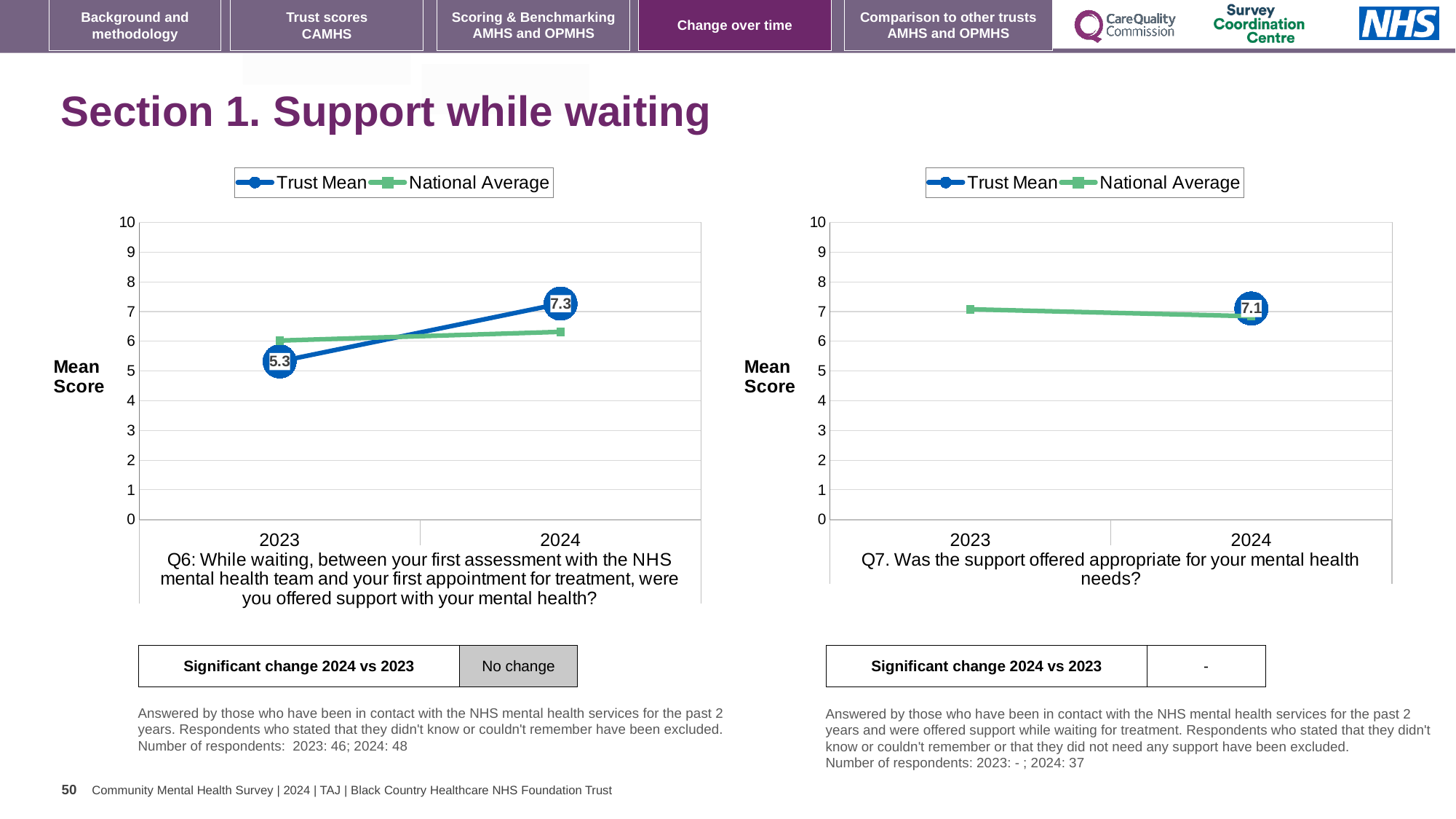
In the left chart (Q6), is the National Average value for 2023 greater or less than 5? greater How many years are shown on the x axis of the left chart (Q6)? 2 In the left chart (Q6), what is the Trust Mean score for 2023? 5.3 In the left chart (Q6), which is larger in 2024, the Trust Mean or the National Average? Trust Mean What type of chart is used for Q6 on the left? line chart In the left chart (Q6), by how much did the Trust Mean score increase from 2023 to 2024? 2.0 In the left chart (Q6), does the Trust Mean rise or fall from 2023 to 2024? rise In the right chart (Q7), what is the Trust Mean score for 2024? 7.1 In the right chart (Q7), is the National Average value for 2023 greater or less than 6? greater What are the two series named in the legend of the left chart (Q6)? Trust Mean and National Average How many series does the legend of the right chart (Q7) list? 2 In the left chart (Q6), what is the Trust Mean score for 2024? 7.3